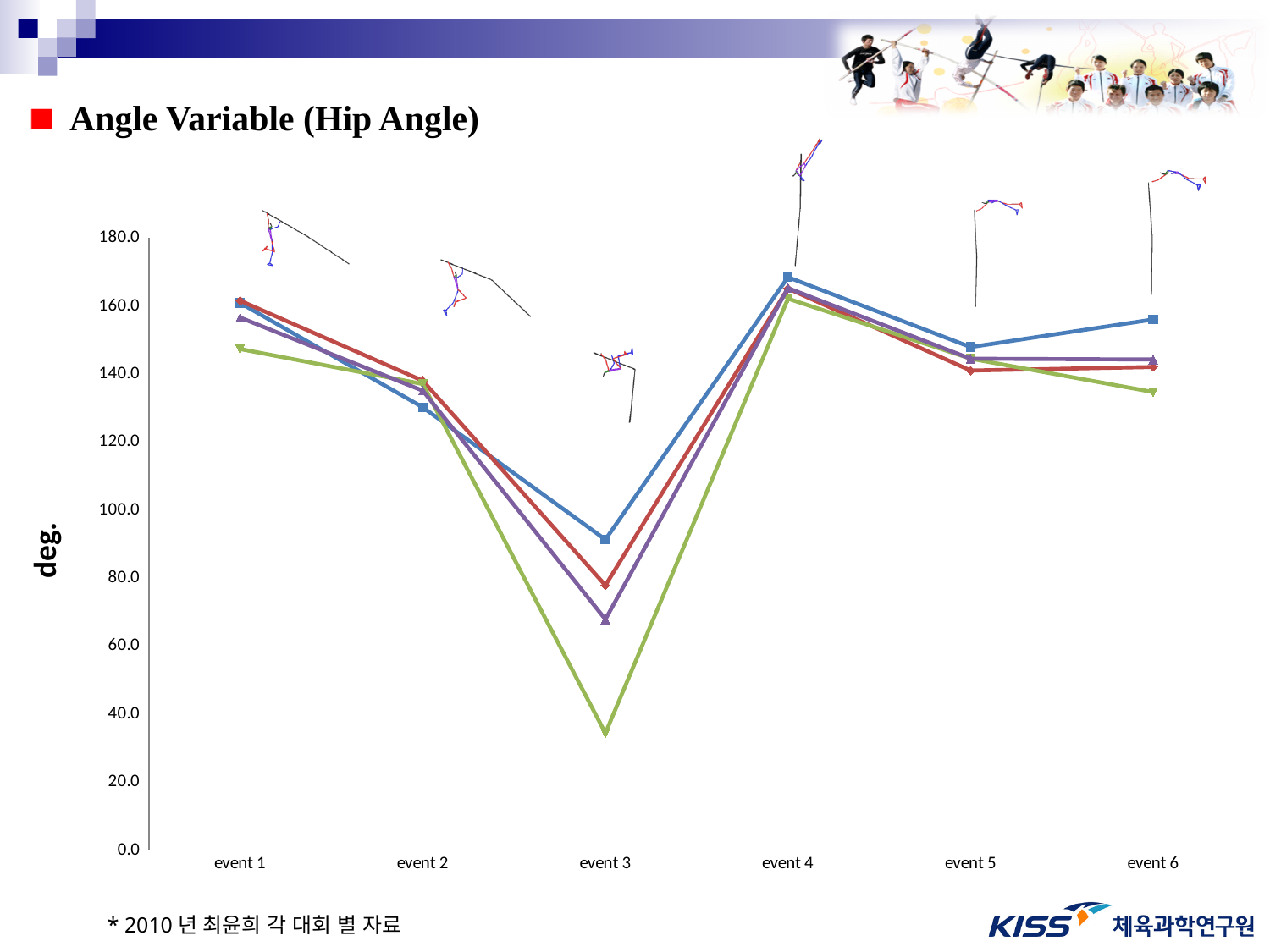
What is the label on the y axis? deg. Is the value of the blue line at event 3 greater or less than 80.0? greater Is the value of the green line at event 3 greater or less than 40.0? less What kind of chart is shown on the slide? line chart Do the values of all lines rise or fall from event 2 to event 3? fall At event 3, which line has the larger value, the blue line or the green line? blue line Do the values of all lines rise or fall from event 3 to event 4? rise Is the value of the blue line at event 4 greater or less than 160.0? greater At which event does the green line reach its lowest value? event 3 How many lines are plotted on the chart? 4 How many events are shown along the x axis? 6 At which event does the blue line reach its highest value? event 4